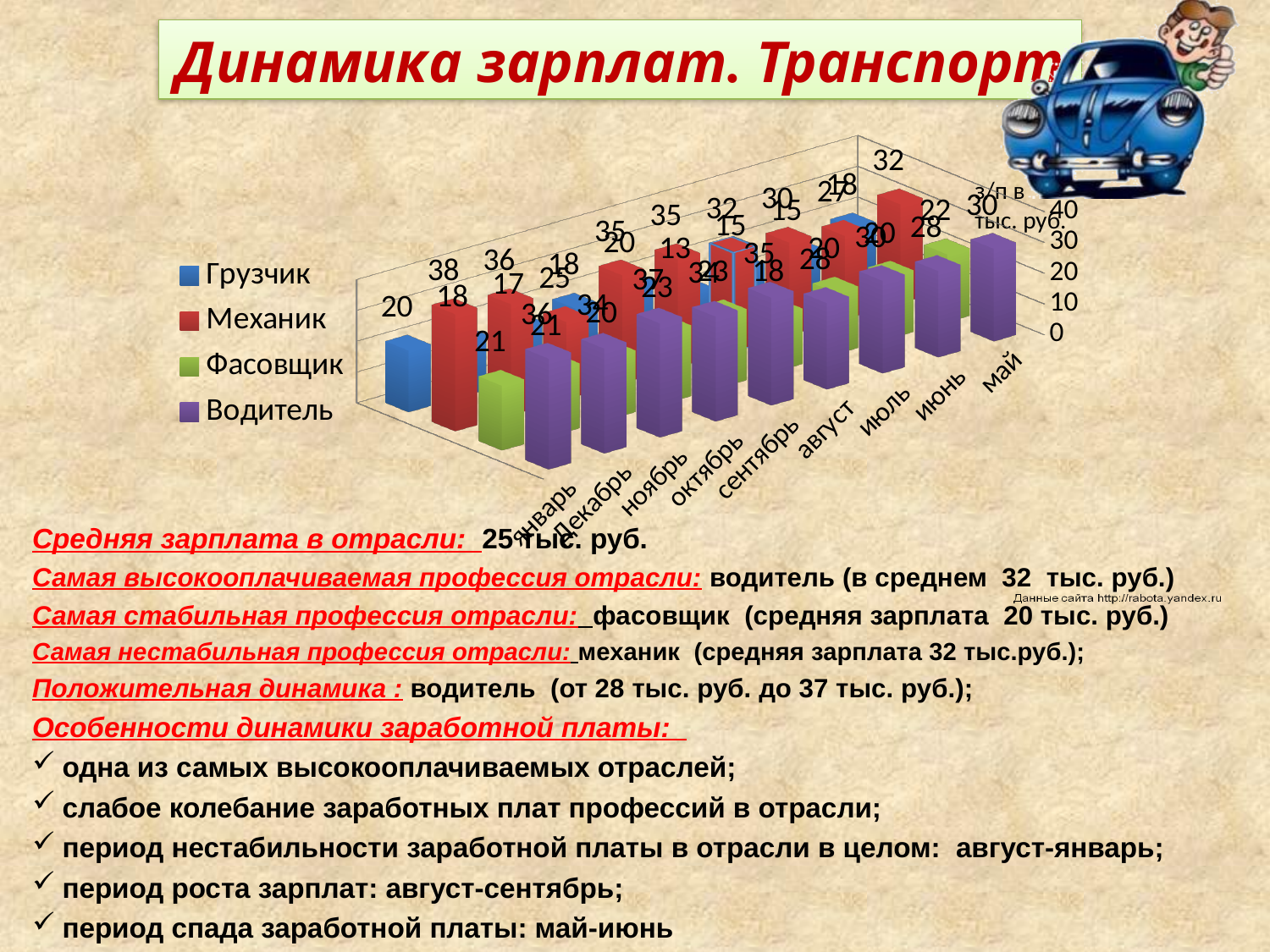
Which professions are listed in the chart legend? Грузчик, Механик, Фасовщик, Водитель Is the value for Грузчик in январь greater or less than 30? less How many series does the chart legend list? 4 What is the highest tick value shown on the value axis? 40 How many month categories are shown along the x axis of the chart? 9 Which month is the last category on the x axis? май What kind of chart is shown on the slide? bar chart What is the title of the value axis of the chart? з/п в тыс. руб. Which month is the first category on the x axis? январь What is the value for Грузчик in январь? 20